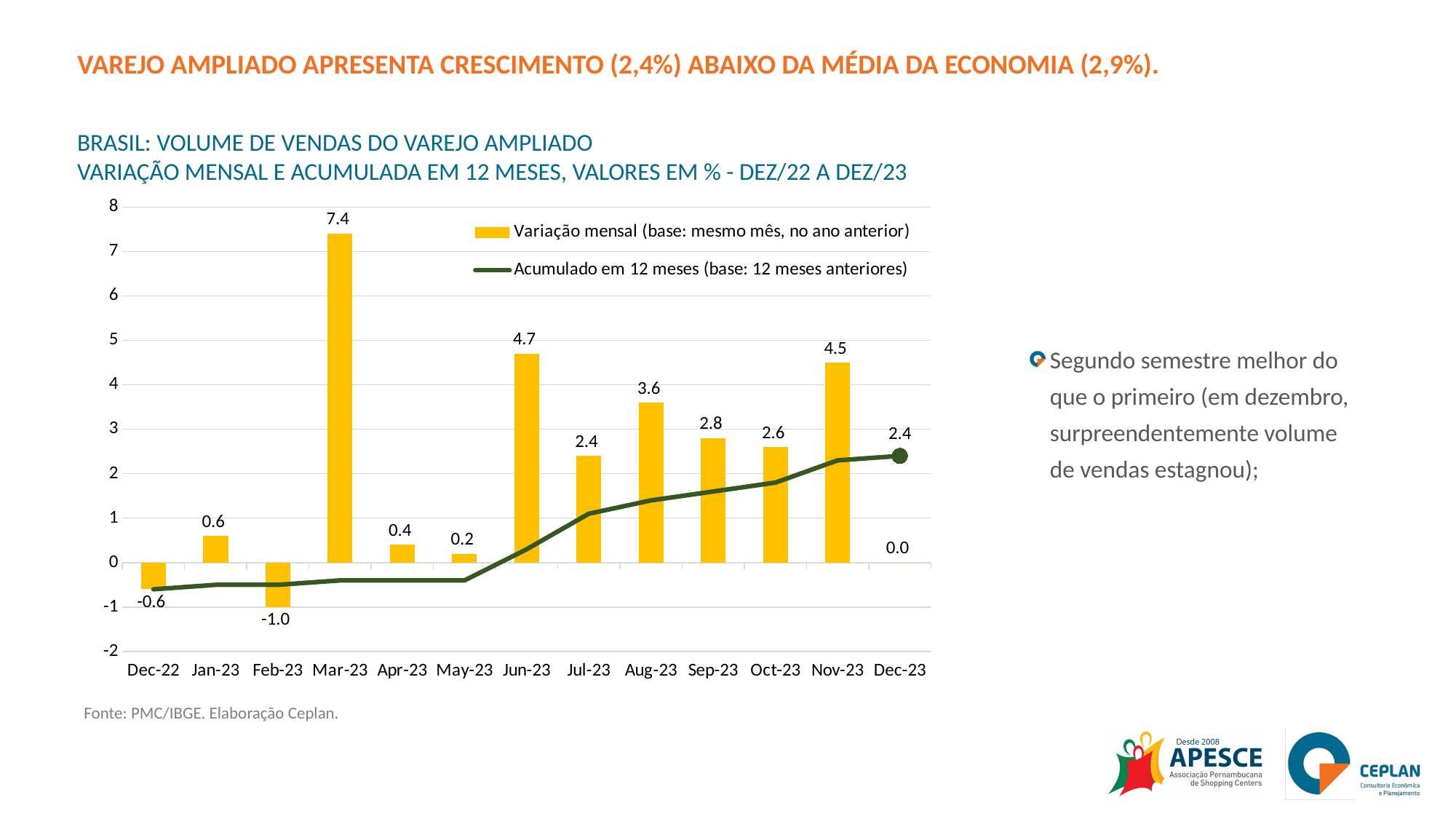
Does the Acumulado em 12 meses line rise or fall from Jun-23 to Dec-23? rise Which is larger, the Variação mensal value for Aug-23 or for Sep-23? Aug-23 How many series does the legend list? 2 How many months are shown on the x axis? 13 Is the Acumulado em 12 meses line value for Jun-23 greater or less than 1? less What is the value of the Variação mensal bar for Feb-23? -1.0 Which month has the highest Variação mensal bar? Mar-23 Which month has the lowest Variação mensal bar? Feb-23 What is the labelled value of the Acumulado em 12 meses line at Dec-23? 2.4 What is the difference between the Variação mensal values for Jun-23 and Jul-23? 2.3 What is the value of the Variação mensal bar for Nov-23? 4.5 What is the value of the Variação mensal bar for Mar-23? 7.4